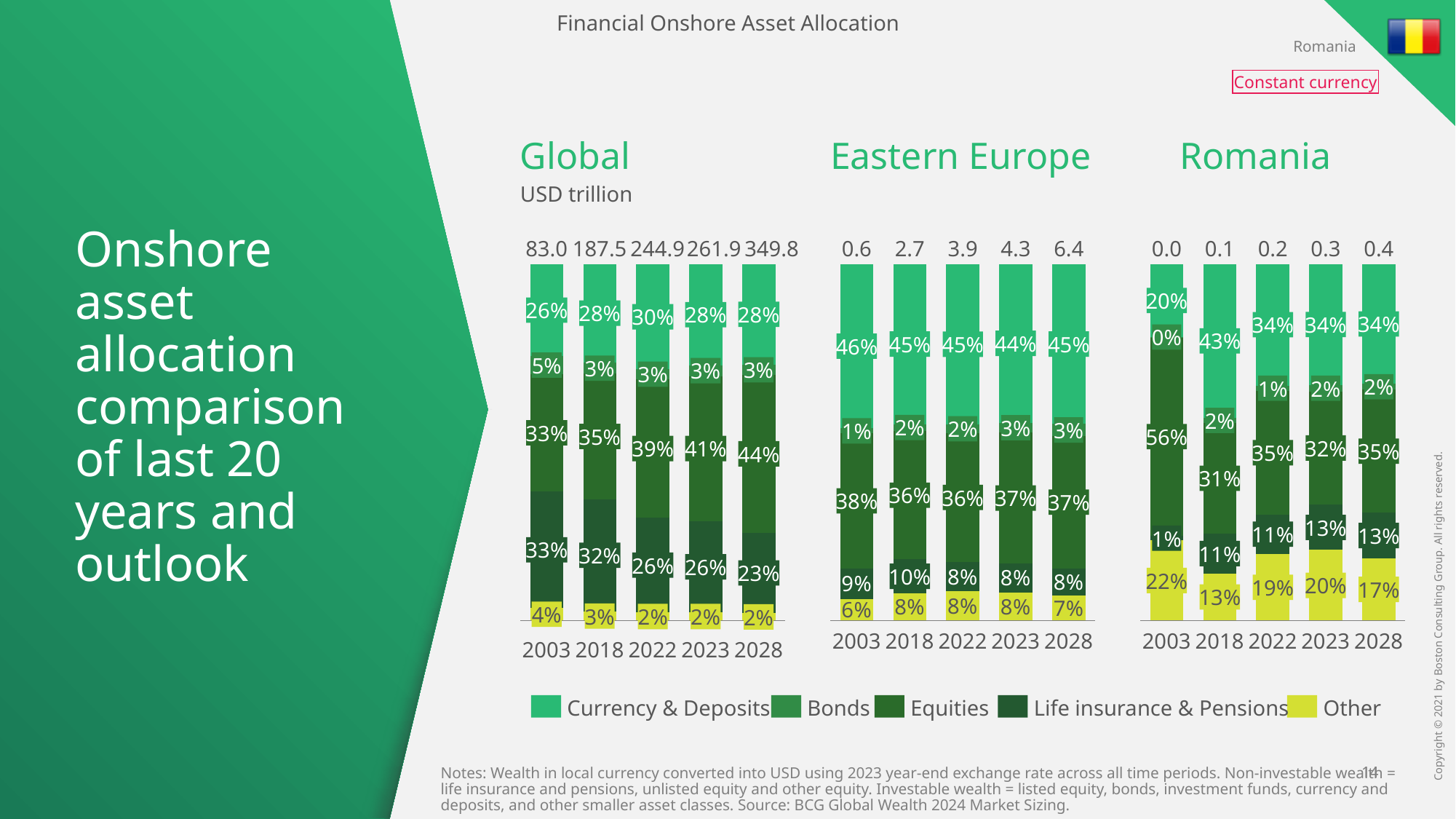
In the Romania chart, which year has the highest share of Currency & Deposits? 2018 How many series does the legend list? 5 In the Global chart, which year has the lowest share of Life insurance & Pensions? 2028 In the Eastern Europe chart, what share of assets is Currency & Deposits in 2003? 46% In the Global chart, does the total value rise or fall from 2003 to 2028? Rise How many years are shown on the x axis of the Romania chart? 5 In the Global chart, what is the difference between the total values for 2028 and 2023? 87.9 In the Global chart, what share of assets is Equities in 2023? 41% In the Romania chart, what share of assets is Other in 2003? 22% In the Global chart, what is the total onshore asset value shown for 2028? 349.8 In the Eastern Europe chart, is the Equities share larger in 2003 or in 2018? 2003 What kind of chart is used for the Global data? Stacked bar chart